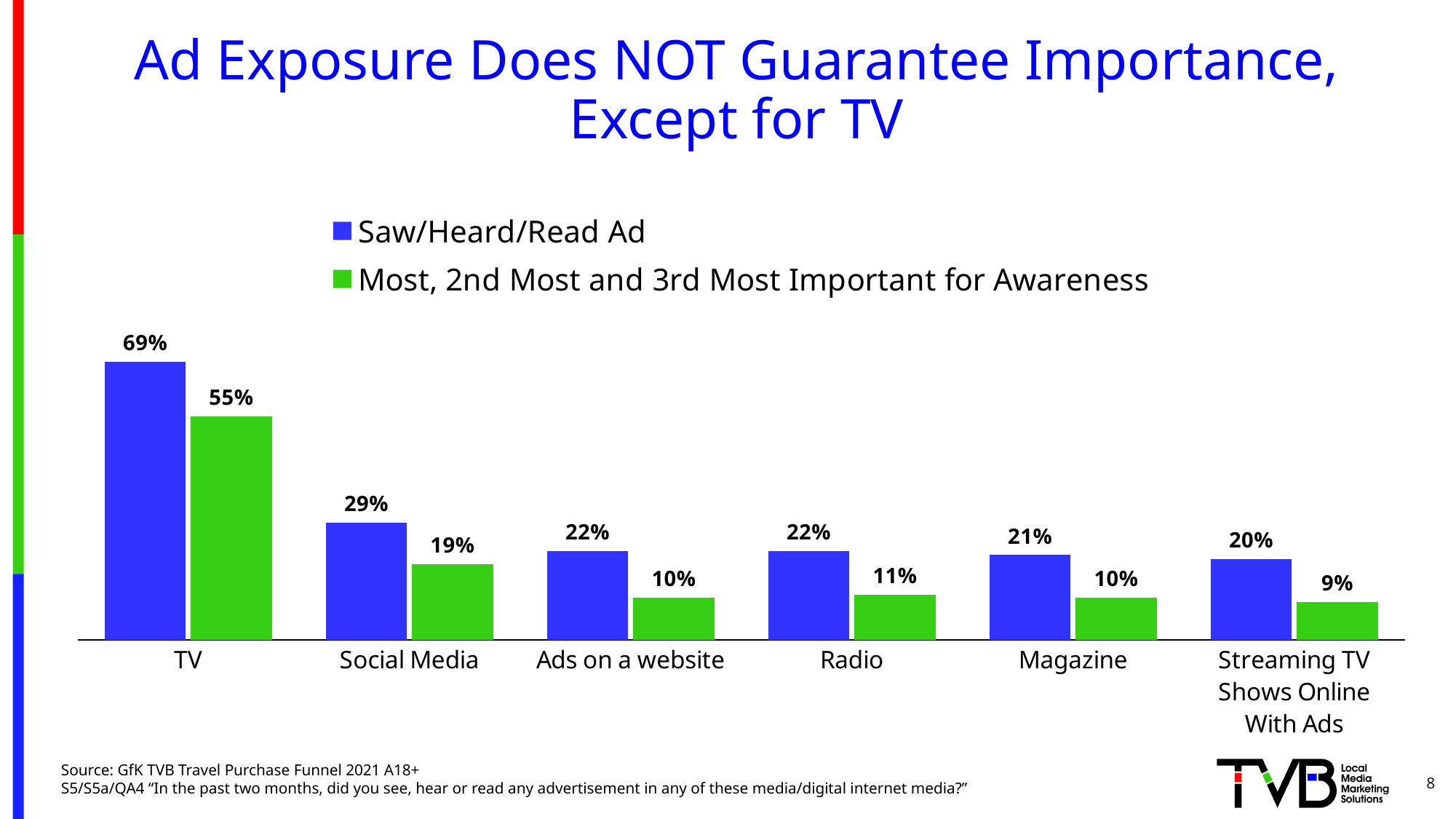
Which category has the highest Saw/Heard/Read Ad value? TV What is the difference between the Saw/Heard/Read Ad value and the Most, 2nd Most and 3rd Most Important for Awareness value for TV? 14% What colour are the Saw/Heard/Read Ad bars? Blue What is the Saw/Heard/Read Ad value for TV? 69% Which category has the lowest Most, 2nd Most and 3rd Most Important for Awareness value? Streaming TV Shows Online With Ads What kind of chart is shown on the slide? Bar chart What is the difference between the Saw/Heard/Read Ad values for Social Media and Radio? 7% How many categories are shown on the x axis? 6 Which is larger: the Most, 2nd Most and 3rd Most Important for Awareness value for Radio or for Magazine? Radio What is the Saw/Heard/Read Ad value for Streaming TV Shows Online With Ads? 20% What is the Most, 2nd Most and 3rd Most Important for Awareness value for Social Media? 19% How many series does the legend list? 2